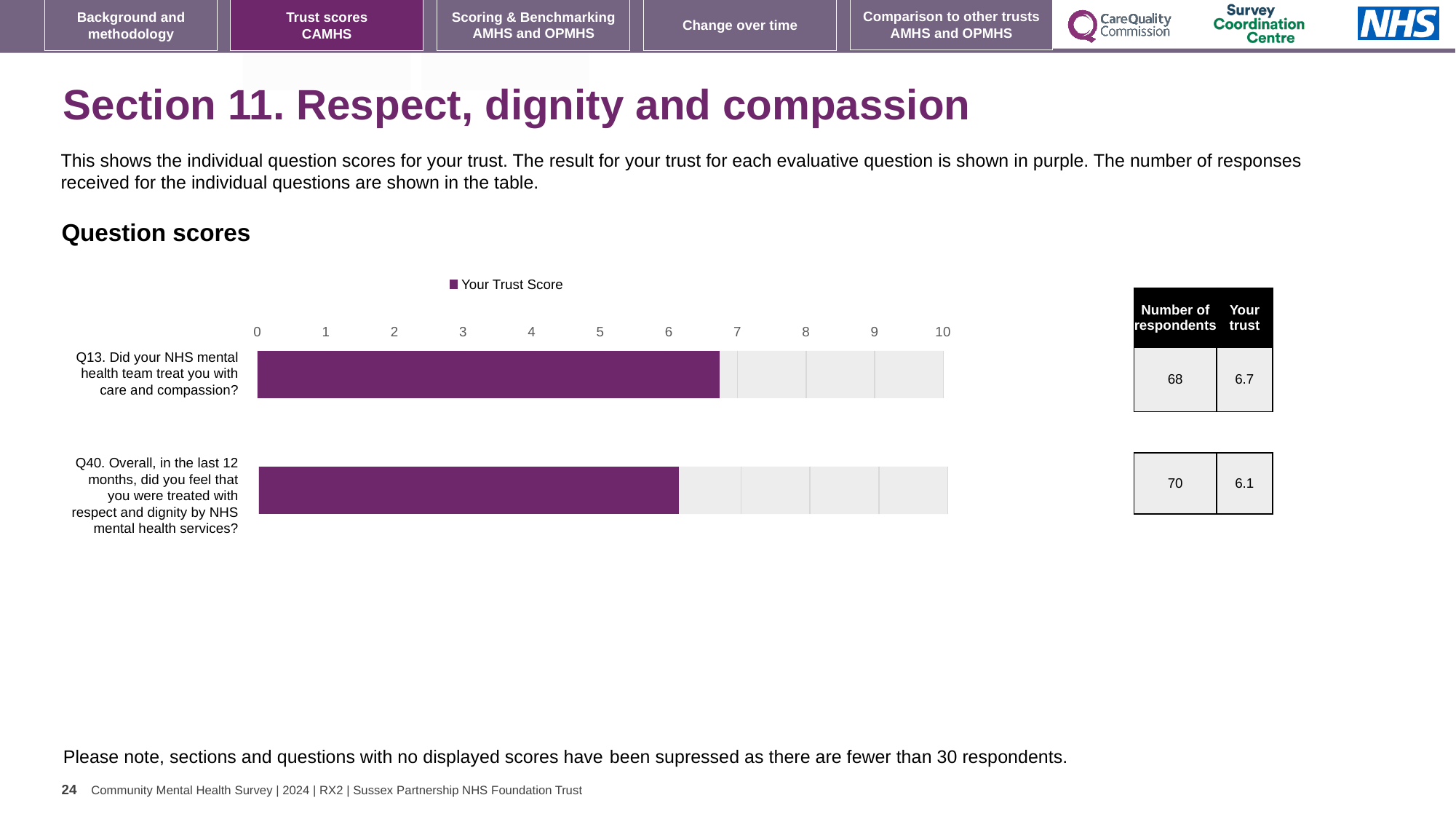
What is the difference between the Your Trust Scores for Q13 and Q40? 0.6 What type of chart is used to show the question scores? Bar chart Is the Your Trust Score for Q40 greater or less than 7? less How many questions are plotted on the Question scores chart? 2 What is the Your Trust Score for Q13 (Did your NHS mental health team treat you with care and compassion?)? 6.7 Which question has the lowest Your Trust Score on the chart? Q40 Is the Your Trust Score for Q13 greater or less than 6? greater Which question has the highest Your Trust Score on the chart? Q13 Which question has the higher Your Trust Score, Q13 or Q40? Q13 What is the Your Trust Score for Q40 (Overall, in the last 12 months, did you feel that you were treated with respect and dignity by NHS mental health services?)? 6.1 How many series does the legend of the Question scores chart list? 1 What is the maximum value shown on the x axis of the Question scores chart? 10